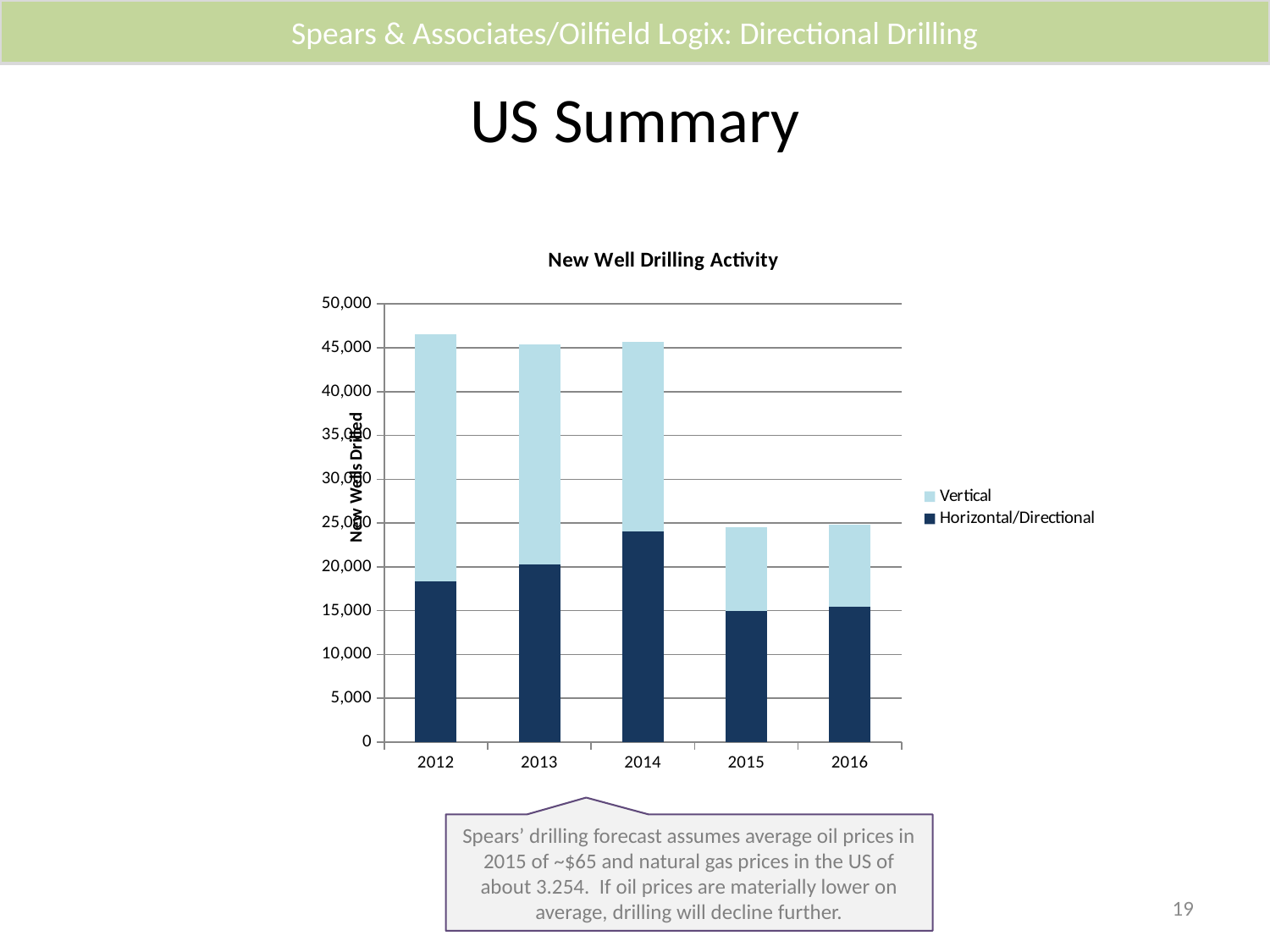
What is the label on the y axis of the New Well Drilling Activity chart? New Wells Drilled Is the total number of new wells drilled in 2012 greater or less than 45,000? greater Which year has the highest Horizontal/Directional value in the New Well Drilling Activity chart? 2014 How many series does the legend of the New Well Drilling Activity chart list? 2 Which is larger: the Horizontal/Directional value for 2013 or for 2014? 2014 How many years are shown on the x axis of the New Well Drilling Activity chart? 5 Which year has the larger total bar: 2014 or 2015? 2014 Is the Horizontal/Directional value for 2014 greater or less than 20,000? greater Does the Horizontal/Directional value rise or fall from 2012 to 2014? rise What kind of chart is shown under the title "New Well Drilling Activity"? Stacked bar chart Is the total number of new wells drilled in 2015 greater or less than 30,000? less